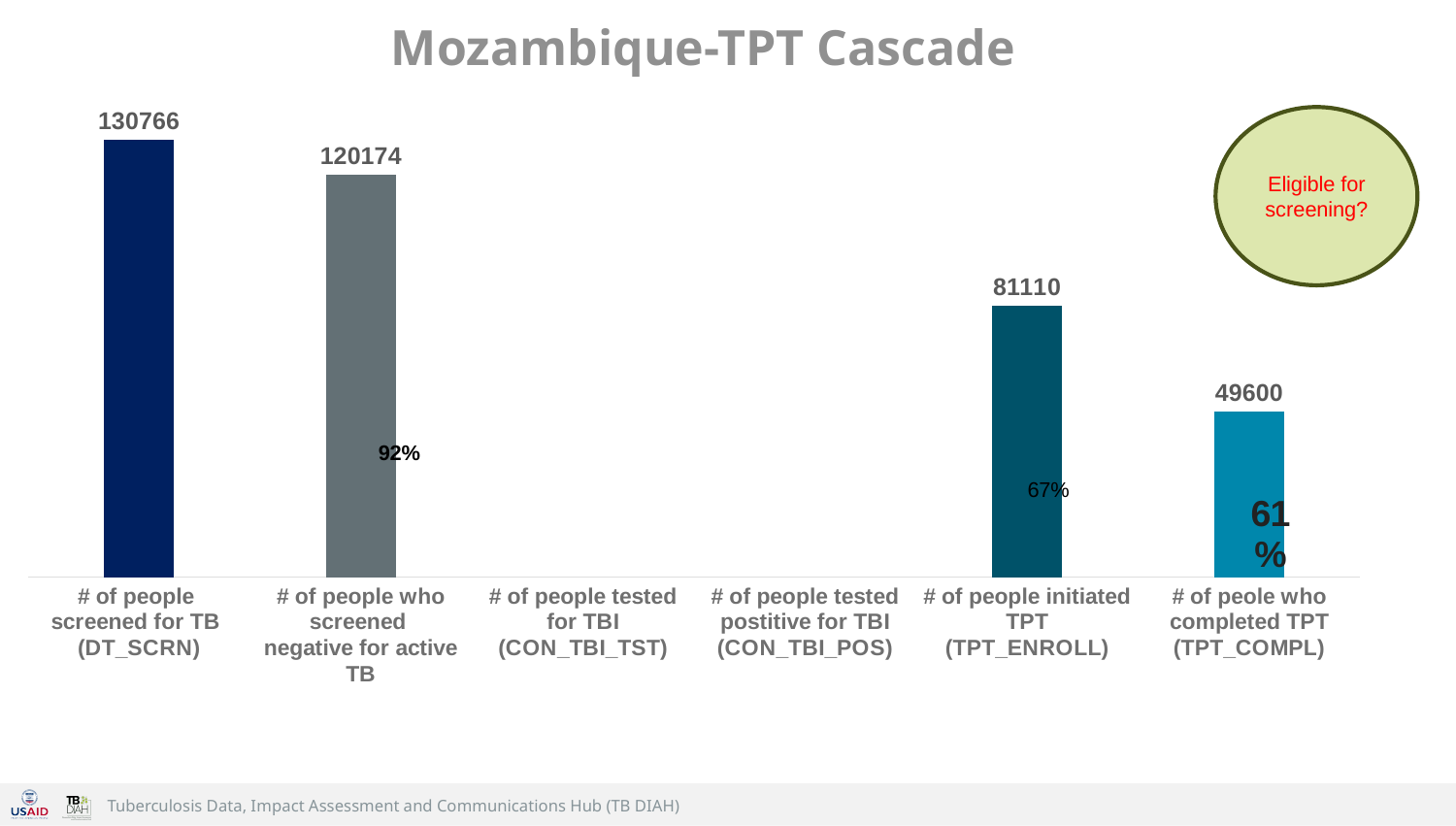
What is the value for # of people initiated TPT (TPT_ENROLL)? 81110 What is the value for # of peole who completed TPT (TPT_COMPL)? 49600 What is the value for # of people screened for TB (DT_SCRN)? 130766 What is the title of the chart? Mozambique-TPT Cascade Which category has the highest value? # of people screened for TB (DT_SCRN) Among the categories with a bar shown, which has the lowest value? # of peole who completed TPT (TPT_COMPL) How many categories are labelled on the x axis of the chart? 6 Which is larger: the value for # of people initiated TPT (TPT_ENROLL) or # of peole who completed TPT (TPT_COMPL)? # of people initiated TPT (TPT_ENROLL) What is the value for # of people who screened negative for active TB? 120174 What type of chart is shown on the slide? bar chart What is the difference between the number of people screened for TB (DT_SCRN) and the number who screened negative for active TB? 10592 What is the difference between the number of people initiated TPT (TPT_ENROLL) and the number who completed TPT (TPT_COMPL)? 31510